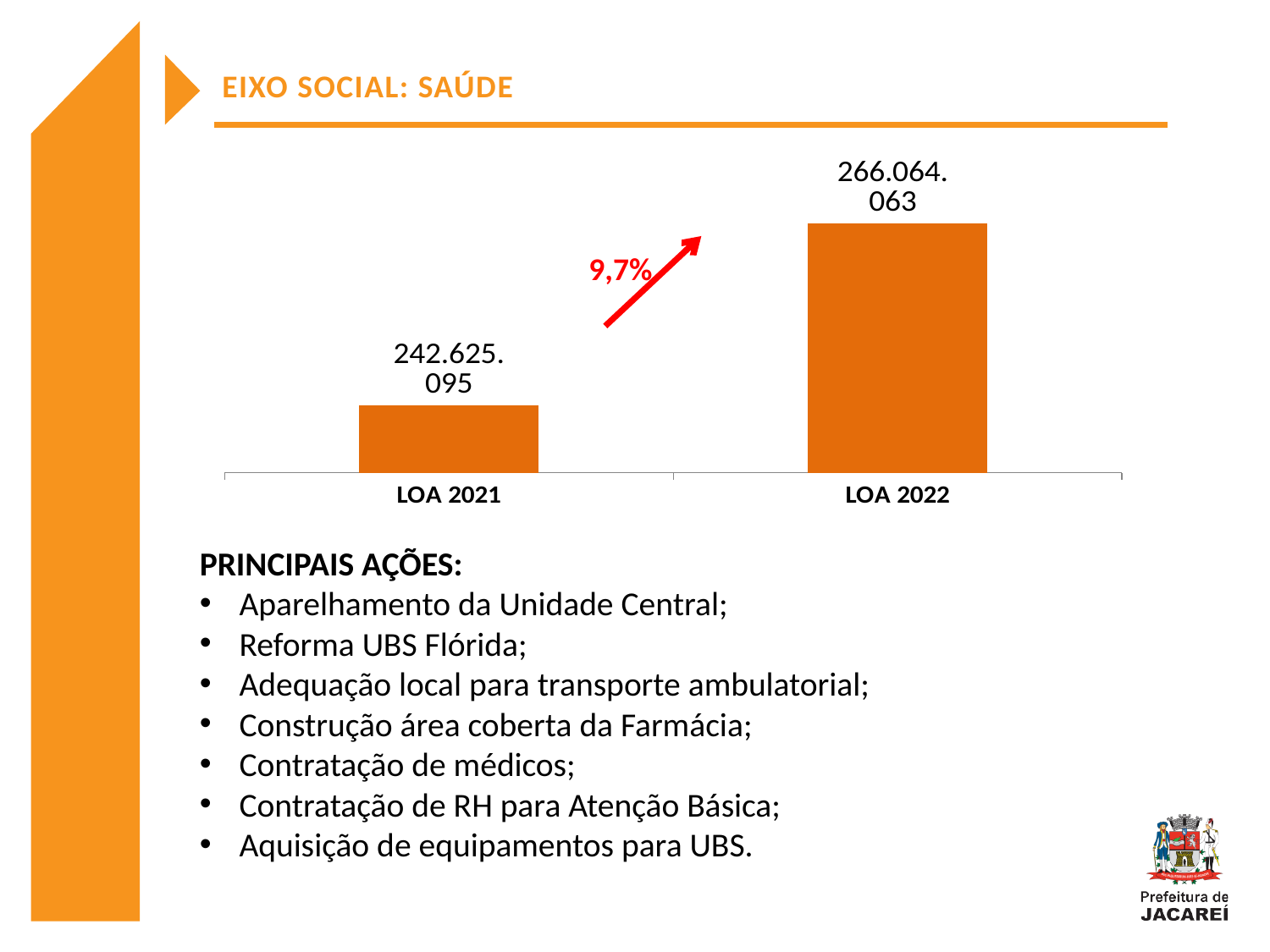
How many categories are shown on the x axis of the chart? 2 What kind of chart is shown on the slide? bar chart Do the values rise or fall from LOA 2021 to LOA 2022? rise Which category has the highest value? LOA 2022 What is the value shown for LOA 2021? 242.625.095 Which category has the lowest value? LOA 2021 What is the difference between the values for LOA 2022 and LOA 2021? 23.438.968 What percentage change is written next to the red arrow on the chart? 9,7% Which is larger, the value for LOA 2021 or the value for LOA 2022? LOA 2022 What is the value shown for LOA 2022? 266.064.063 What colour are the bars in the chart? orange